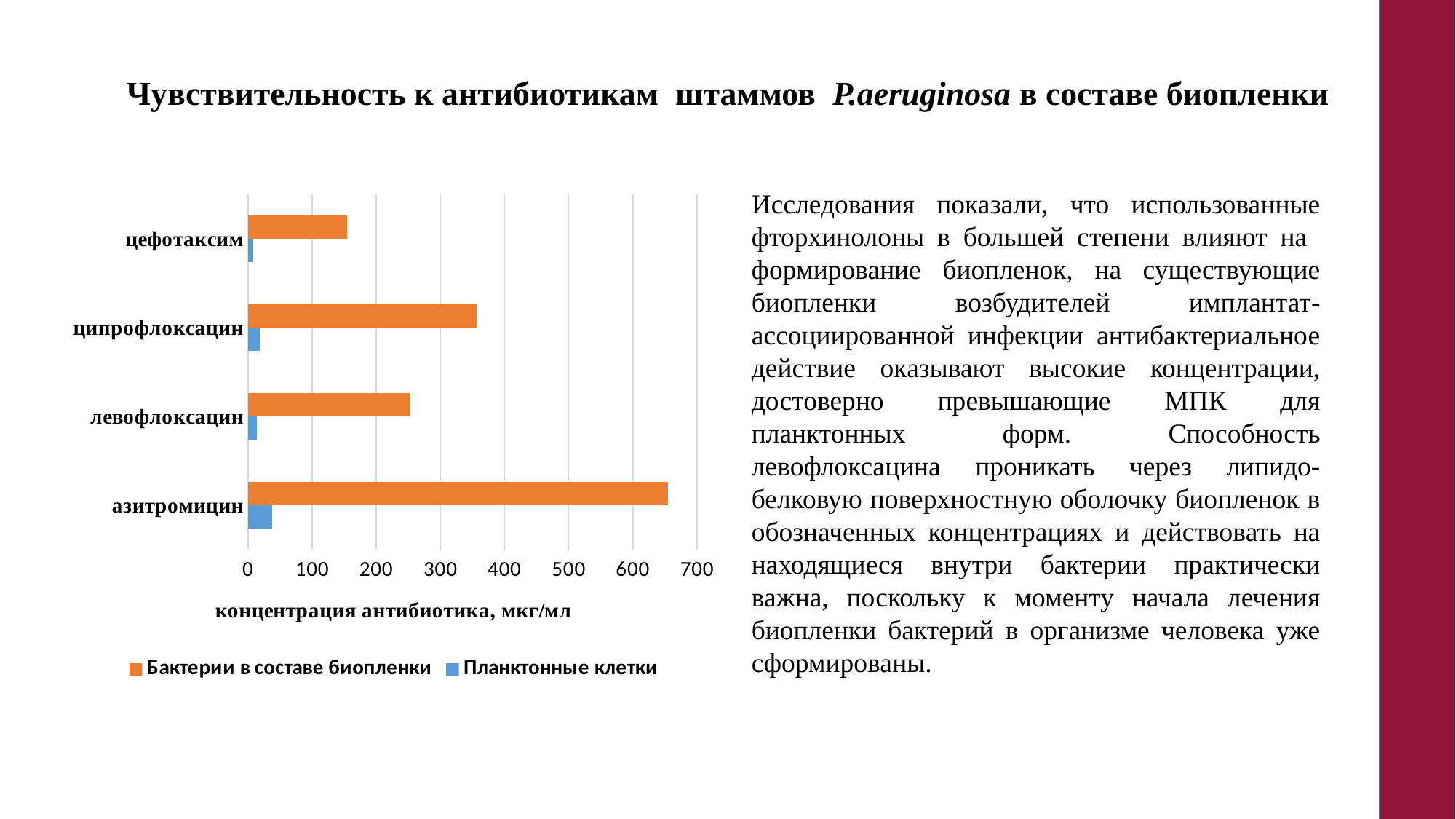
Is the value for цефотаксим in the series 'Бактерии в составе биопленки' greater or less than 200? less Is the value for азитромицин in the series 'Планктонные клетки' greater or less than 100? less Is the value for азитромицин in the series 'Бактерии в составе биопленки' greater or less than 600? greater What kind of chart is shown on the slide? bar chart What is the title of the horizontal axis of the chart? концентрация антибиотика, мкг/мл For the series 'Бактерии в составе биопленки', which is larger: ципрофлоксацин or левофлоксацин? ципрофлоксацин Which antibiotic has the lowest value for the series 'Бактерии в составе биопленки'? цефотаксим Which antibiotic has the highest value for the series 'Бактерии в составе биопленки'? азитромицин How many antibiotics (categories) are shown on the chart? 4 How many series does the chart legend list? 2